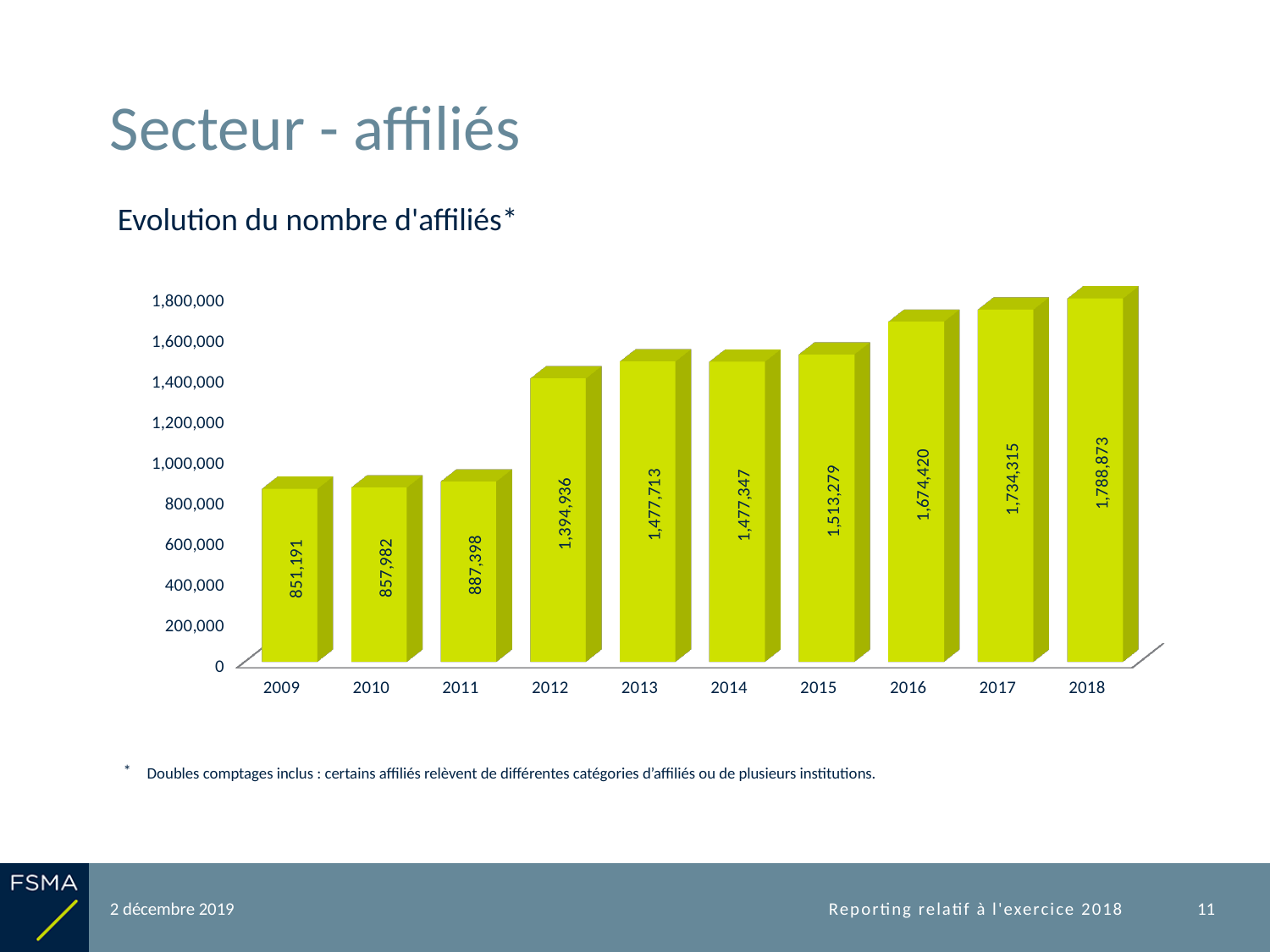
What is the difference between the values for 2018 and 2009? 937,682 Which year has the highest value? 2018 What is the value for 2012? 1,394,936 What is the value for 2009? 851,191 What is the value for 2016? 1,674,420 Which is larger, the value for 2015 or the value for 2011? 2015 What kind of chart is shown on the slide? bar chart Which year has the lowest value? 2009 Is the value for 2015 greater or less than 1,400,000? greater How many years are shown on the x axis? 10 Do the values generally rise or fall from 2009 to 2018? rise What is the difference between the values for 2012 and 2011? 507,538